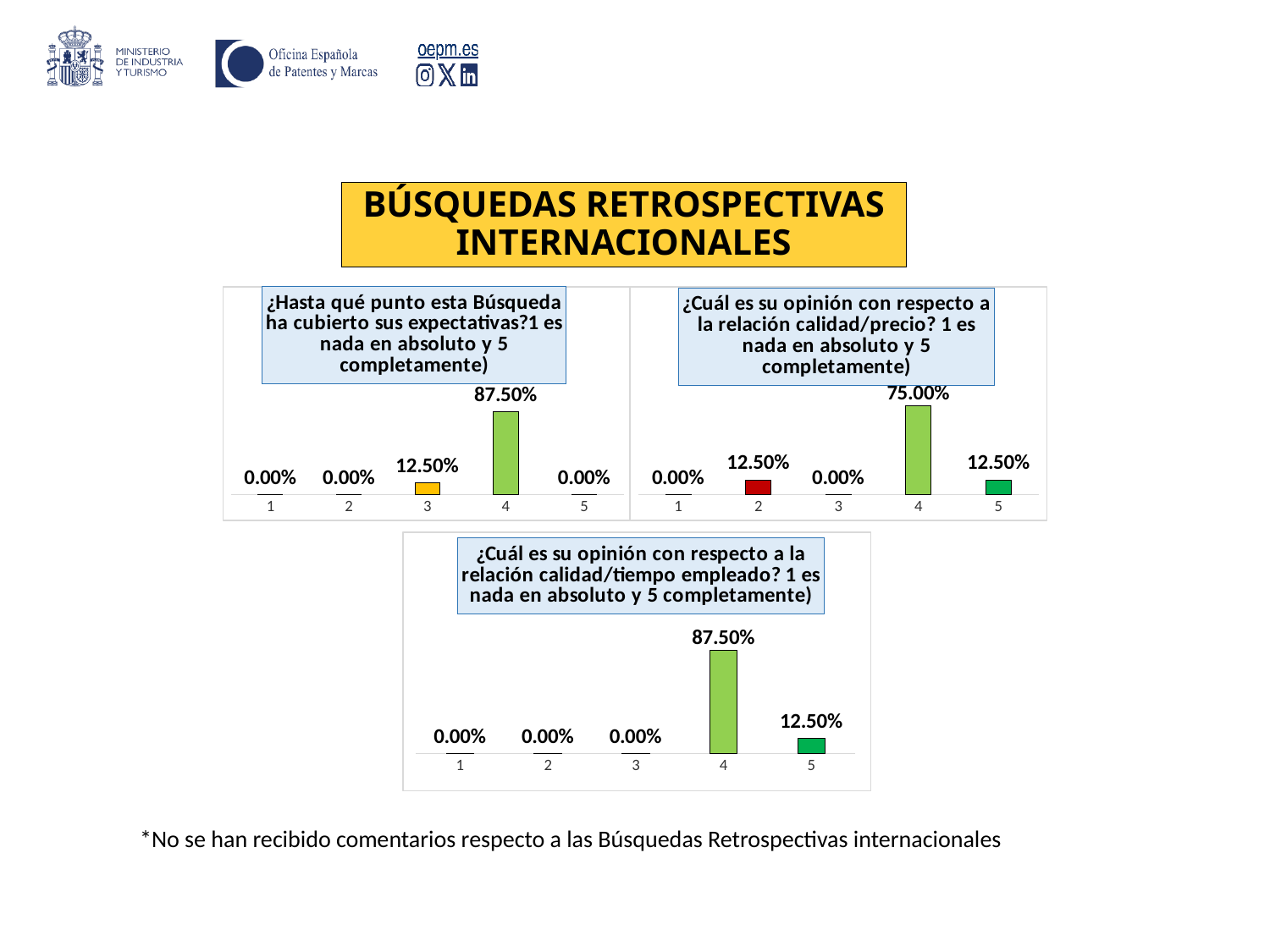
In the bottom chart (relación calidad/tiempo empleado), which category has the highest value? 4 What type of chart is the bottom chart (relación calidad/tiempo empleado)? Bar chart In the bottom chart (relación calidad/tiempo empleado), what is the value for category 5? 12.50% In the top-left chart (¿Hasta qué punto esta Búsqueda ha cubierto sus expectativas?), what is the value for category 3? 12.50% In the top-right chart (relación calidad/precio), what is the value for category 2? 12.50% How many categories are shown on the x axis of the top-left chart (¿Hasta qué punto esta Búsqueda ha cubierto sus expectativas?)? 5 In the top-left chart (¿Hasta qué punto esta Búsqueda ha cubierto sus expectativas?), what is the value for category 4? 87.50% In the top-left chart (¿Hasta qué punto esta Búsqueda ha cubierto sus expectativas?), what is the difference between the values for category 4 and category 3? 75.00% In the top-right chart (relación calidad/precio), what is the difference between the values for category 4 and category 5? 62.50% In the top-right chart (relación calidad/precio), what is the value for category 4? 75.00% In the bottom chart (relación calidad/tiempo empleado), which is larger, the value for category 4 or the value for category 5? Category 4 In the top-right chart (relación calidad/precio), which category has the highest value? 4